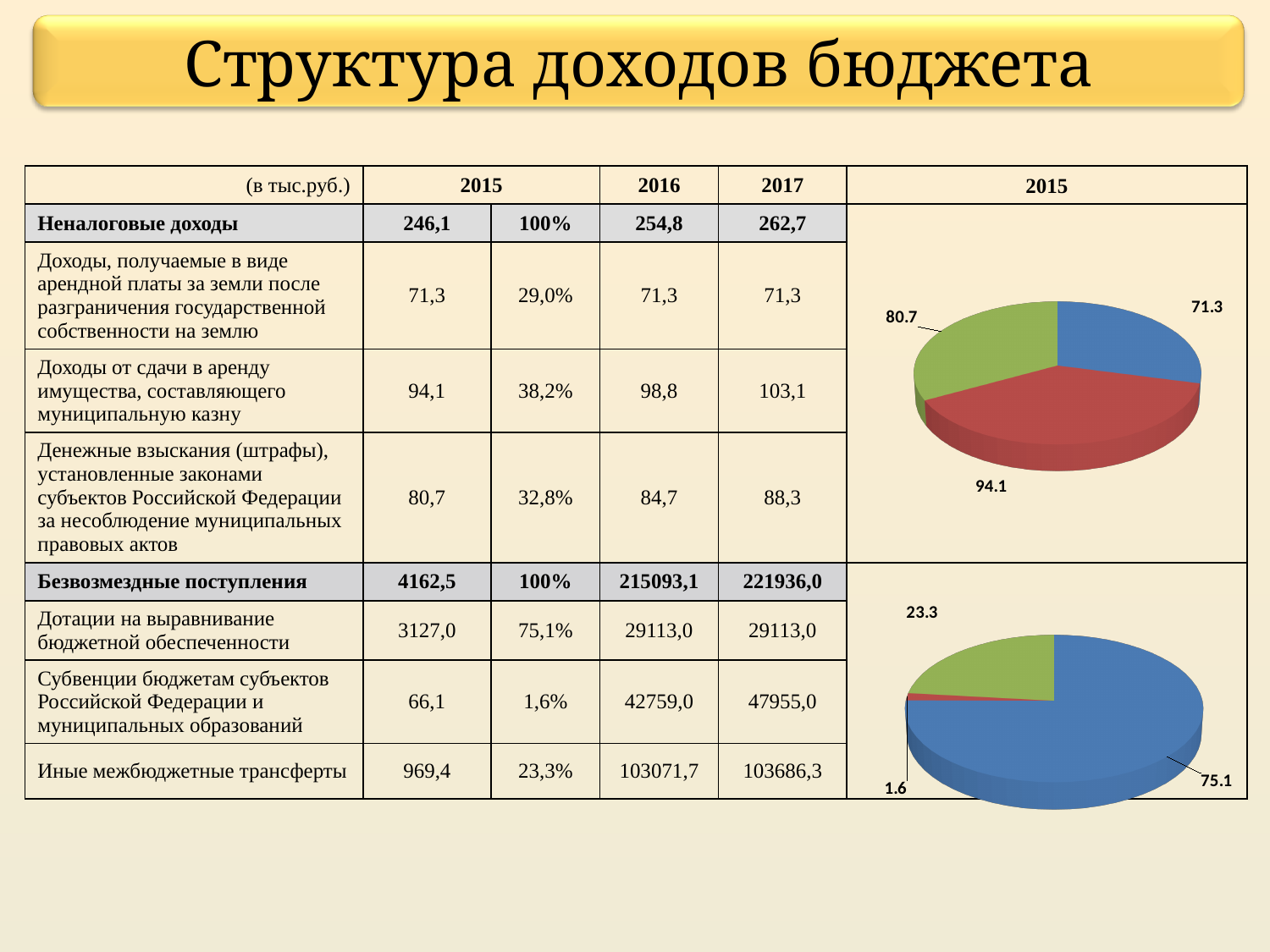
How many slices does the top pie chart (2015, non-tax revenues) have? 3 In the bottom pie chart, is the green slice (23.3) larger or smaller than the blue slice (75.1)? smaller In the bottom pie chart, which labelled value is the smallest? 1.6 In the top pie chart, what is the value labelled on the blue slice? 71.3 In the top pie chart, which labelled value is the largest? 94.1 What type of chart is shown on the right side of the slide for 2015? pie chart In the top pie chart, what is the difference between the red slice (94.1) and the blue slice (71.3)? 22.8 How many slices does the bottom pie chart have? 3 In the top pie chart, what is the value labelled on the green slice? 80.7 In the top pie chart, what is the value labelled on the red slice? 94.1 In the top pie chart, which labelled value is the smallest? 71.3 In the bottom pie chart, what is the value labelled on the blue slice? 75.1